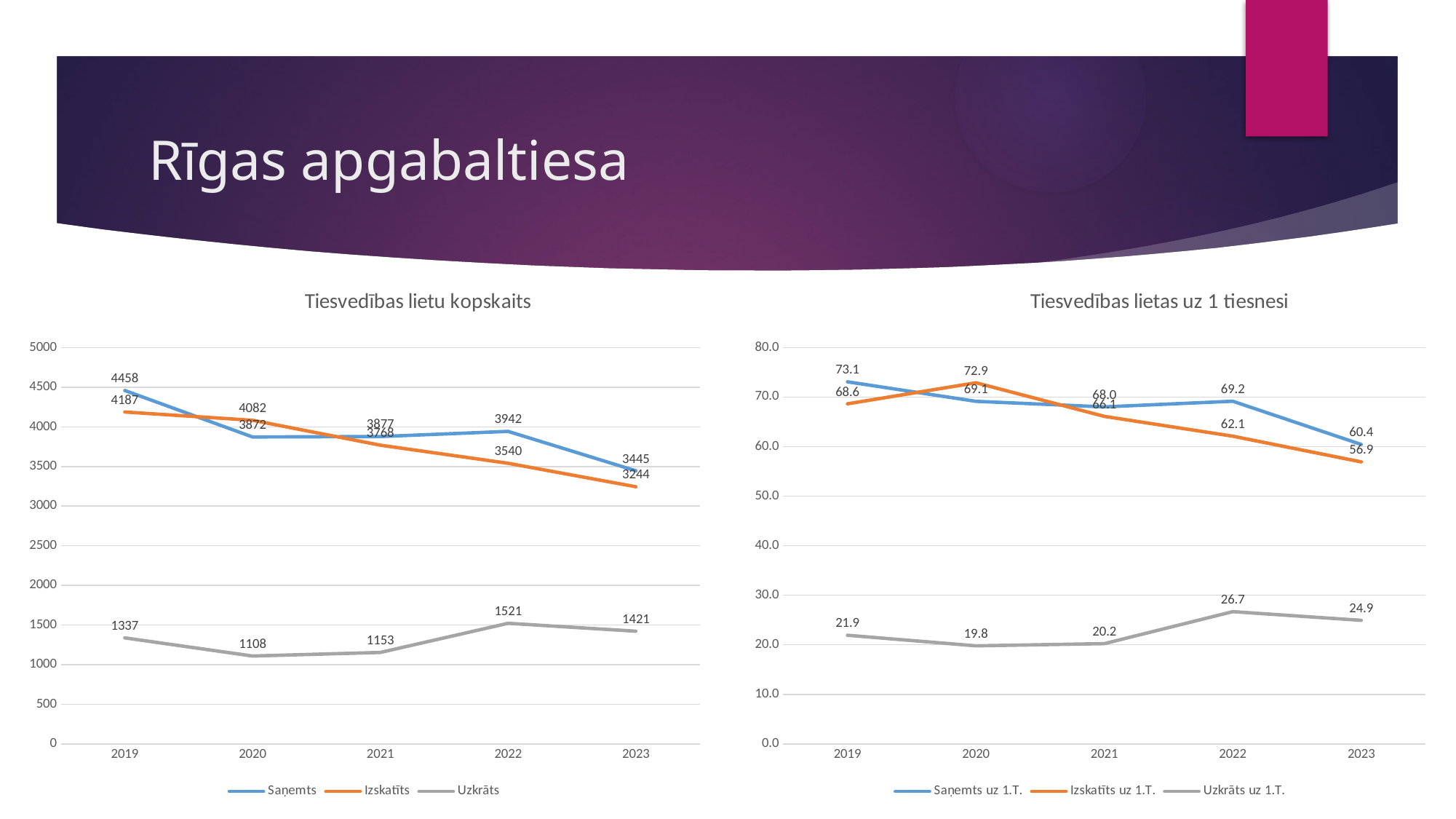
In the chart titled "Tiesvedības lietas uz 1 tiesnesi", what is the value of Uzkrāts uz 1.T. in 2023? 24.9 In the chart titled "Tiesvedības lietu kopskaits", what is the difference between Saņemts and Izskatīts in 2022? 402 In the chart titled "Tiesvedības lietas uz 1 tiesnesi", what is the value of Izskatīts uz 1.T. in 2020? 72.9 What kind of chart is the chart titled "Tiesvedības lietas uz 1 tiesnesi"? line chart In the chart titled "Tiesvedības lietu kopskaits", what is the value of Saņemts in 2019? 4458 In the chart titled "Tiesvedības lietas uz 1 tiesnesi", how many years are shown on the x axis? 5 In the chart titled "Tiesvedības lietas uz 1 tiesnesi", does Izskatīts uz 1.T. rise or fall from 2020 to 2023? fall In the chart titled "Tiesvedības lietas uz 1 tiesnesi", which is larger in 2019: Saņemts uz 1.T. or Izskatīts uz 1.T.? Saņemts uz 1.T. In the chart titled "Tiesvedības lietu kopskaits", what is the value of Izskatīts in 2023? 3244 In the chart titled "Tiesvedības lietu kopskaits", in which year is Uzkrāts highest? 2022 In the chart titled "Tiesvedības lietu kopskaits", how many series does the legend list? 3 In the chart titled "Tiesvedības lietu kopskaits", in which year is Uzkrāts lowest? 2020